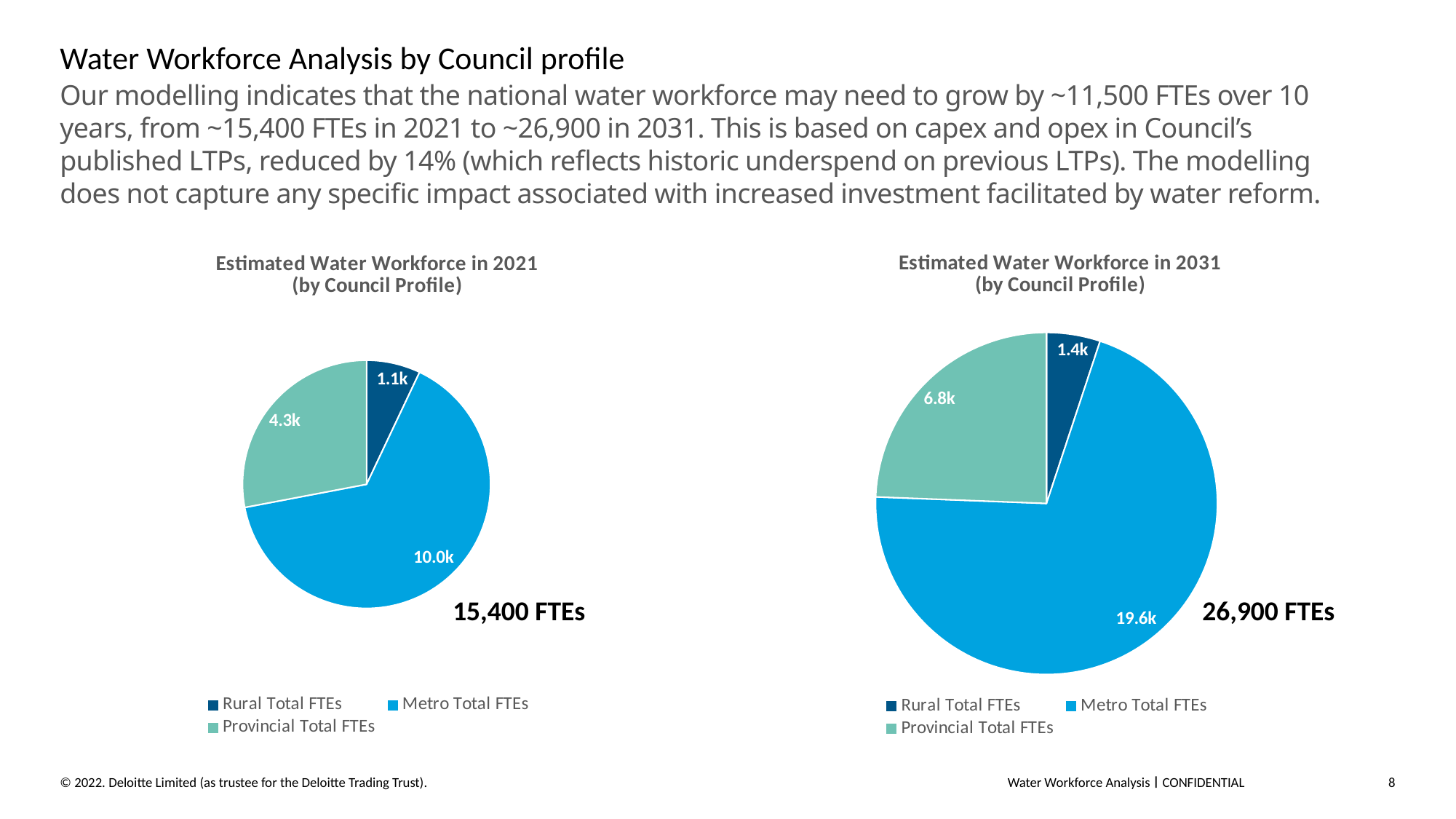
In the 'Estimated Water Workforce in 2031' pie chart, what is the value for Provincial Total FTEs? 6.8k What type of chart is used for 'Estimated Water Workforce in 2021 (by Council Profile)'? Pie chart In the 'Estimated Water Workforce in 2031' pie chart, which council profile has the largest slice? Metro Total FTEs In the 'Estimated Water Workforce in 2021' pie chart, what is the value for Metro Total FTEs? 10.0k What total is printed next to the 'Estimated Water Workforce in 2031' pie chart? 26,900 FTEs What is the difference between Metro Total FTEs in the 2031 pie chart and Metro Total FTEs in the 2021 pie chart? 9.6k In the 'Estimated Water Workforce in 2021' pie chart, which is larger: Provincial Total FTEs or Rural Total FTEs? Provincial Total FTEs How many slices does the 'Estimated Water Workforce in 2031' pie chart have? 3 In the 'Estimated Water Workforce in 2021' pie chart, which council profile has the smallest slice? Rural Total FTEs In the 'Estimated Water Workforce in 2021' pie chart, what is the value for Rural Total FTEs? 1.1k How many series does the legend of the 'Estimated Water Workforce in 2021' pie chart list? 3 In the 'Estimated Water Workforce in 2031' pie chart, what is the value for Rural Total FTEs? 1.4k